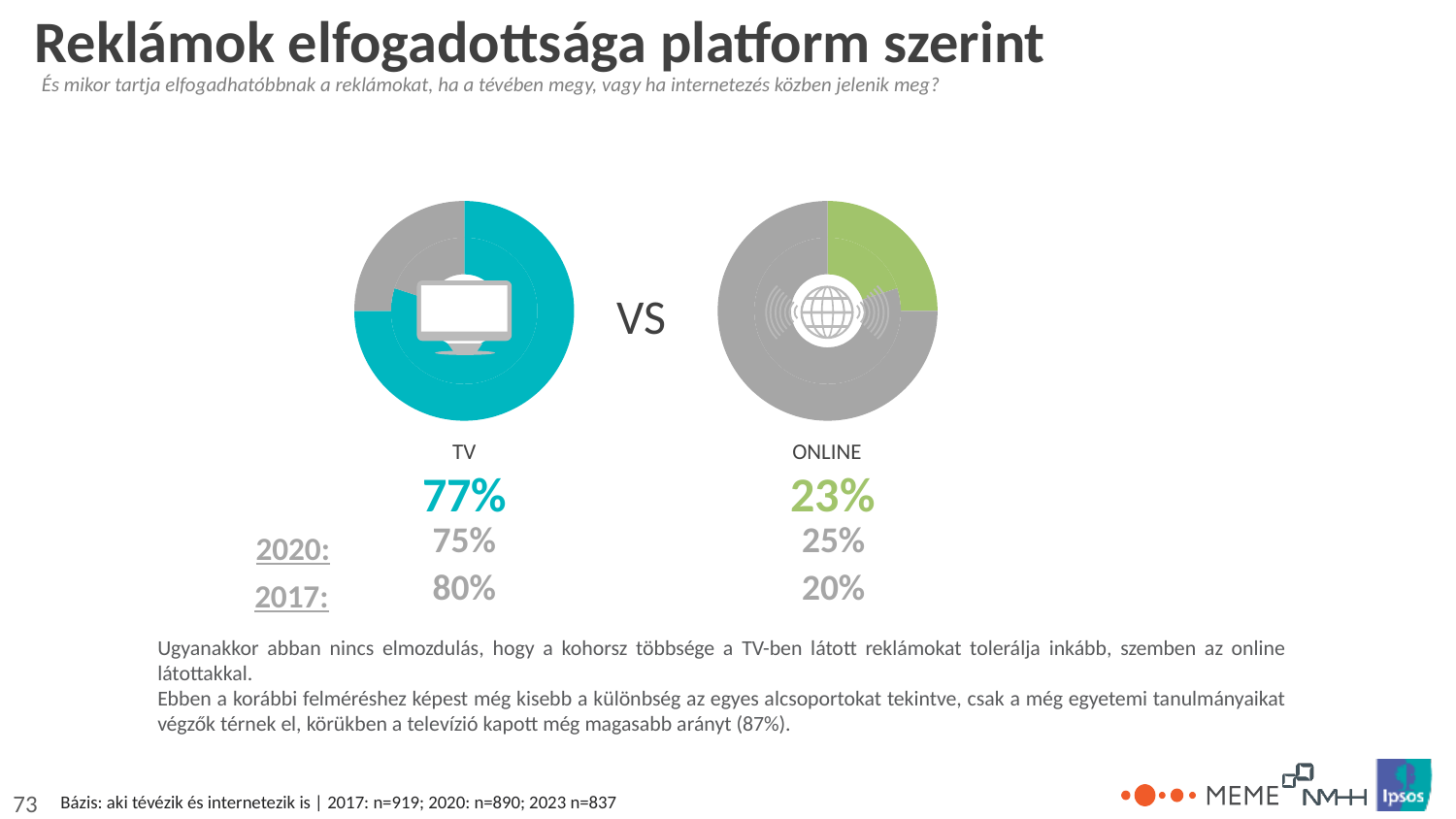
What is the difference in percentage points between the current TV share (77%) and the current ONLINE share (23%)? 54 percentage points What was the TV share in 2020 according to the values under the left donut chart? 75% What kind of chart is used to show the TV and ONLINE shares? Donut (pie) chart What label appears under the left donut chart? TV How many donut charts are shown on the slide? 2 In the left donut chart, what share of respondents find ads more acceptable on TV? 77% What was the ONLINE share in 2017 according to the values under the right donut chart? 20% In the right donut chart, what share of respondents find ads more acceptable online? 23% Did the ONLINE share rise or fall from 2020 (25%) to the current value (23%)? Fall Is the current TV share greater or less than 50%? greater By how many percentage points did the TV share change between 2017 (80%) and the current value (77%)? 3 percentage points Which platform has the larger share in the current values, TV or ONLINE? TV